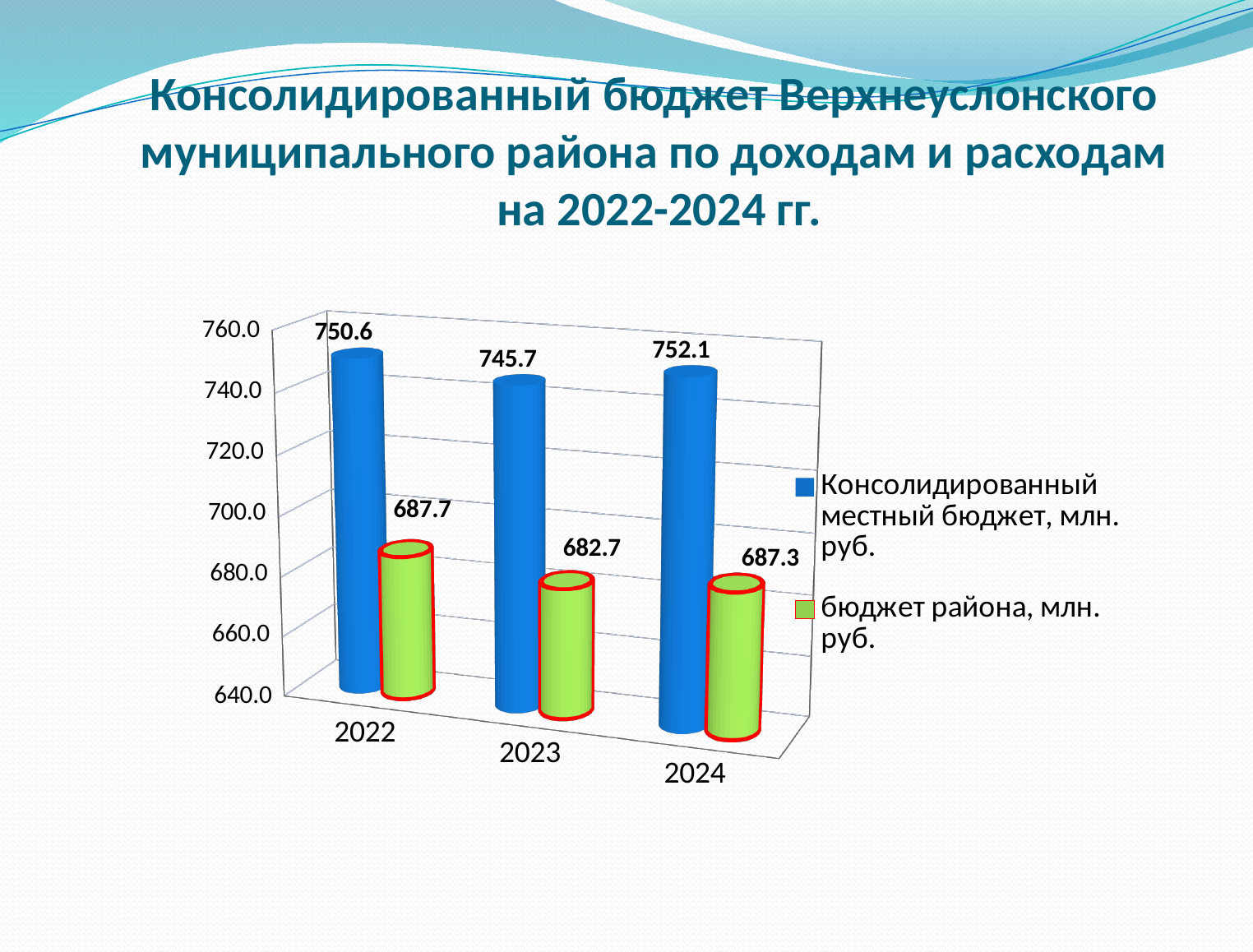
In which year is the consolidated local budget (Консолидированный местный бюджет) the highest? 2024 How many series does the chart legend list? 2 Which is larger: the district budget (бюджет района) in 2022 or in 2024? 2022 What is the difference between the consolidated local budget and the district budget in 2022? 62.9 What is the difference between the consolidated local budget and the district budget in 2024? 64.8 In which year is the district budget (бюджет района) the lowest? 2023 Which colour represents the district budget (бюджет района, млн. руб.) in the chart? green How many years are shown on the x axis of the chart? 3 What is the value of the consolidated local budget (Консолидированный местный бюджет) for 2022? 750.6 What type of chart is shown on the slide? bar chart What is the value of the district budget (бюджет района) for 2023? 682.7 What is the value of the consolidated local budget (Консолидированный местный бюджет) for 2024? 752.1